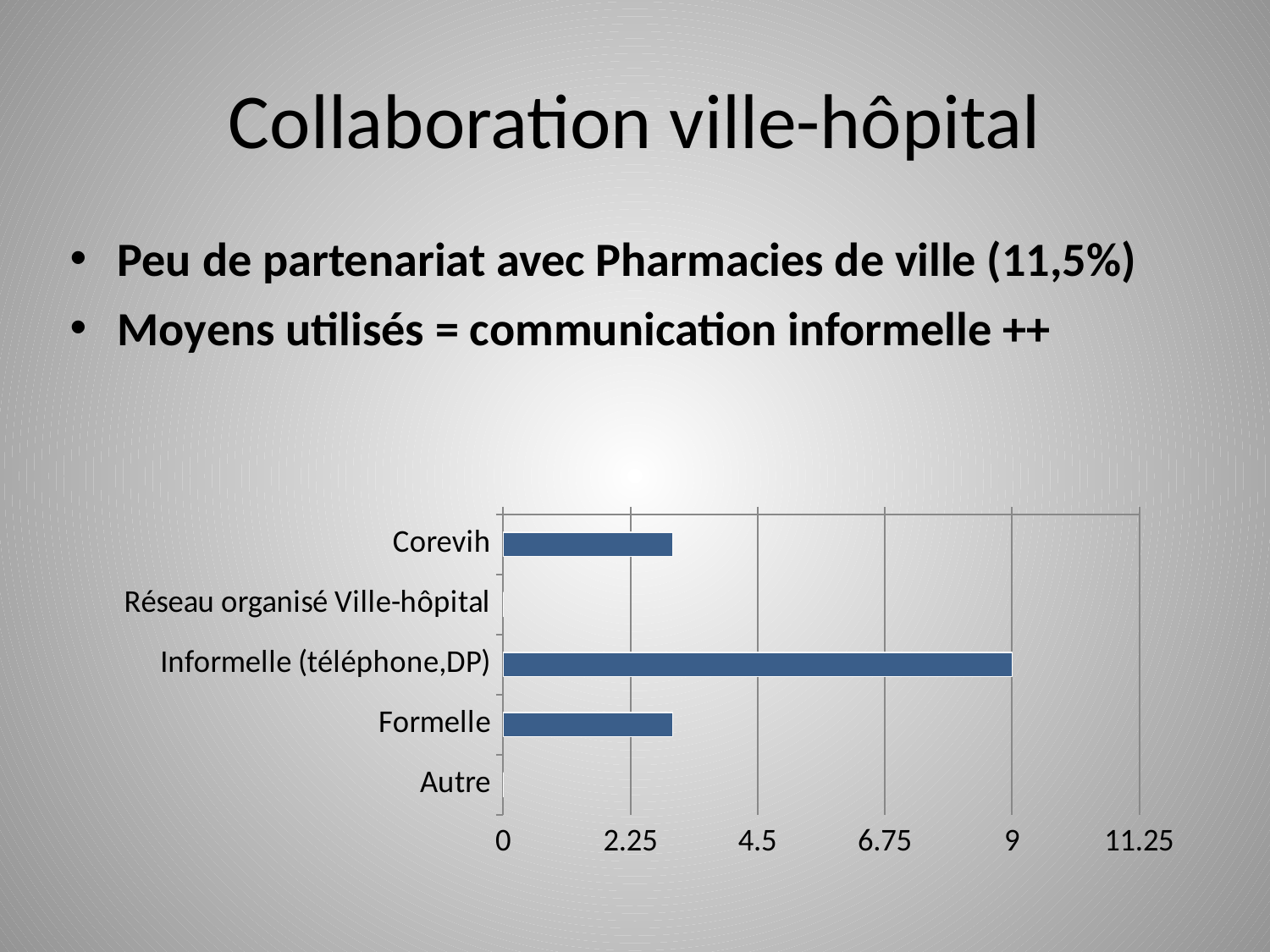
Is the value for Réseau organisé Ville-hôpital greater or less than 2.25? less Is the value for Formelle greater or less than 2.25? greater How many categories are shown on the chart? 5 Is the value for Autre greater or less than 2.25? less Which is larger, the value for Formelle or the value for Autre? Formelle What is the value for Informelle (téléphone,DP)? 9 What kind of chart is shown on the slide? bar chart Which category has the highest value on the chart? Informelle (téléphone,DP) Which is larger, the value for Informelle (téléphone,DP) or the value for Corevih? Informelle (téléphone,DP)